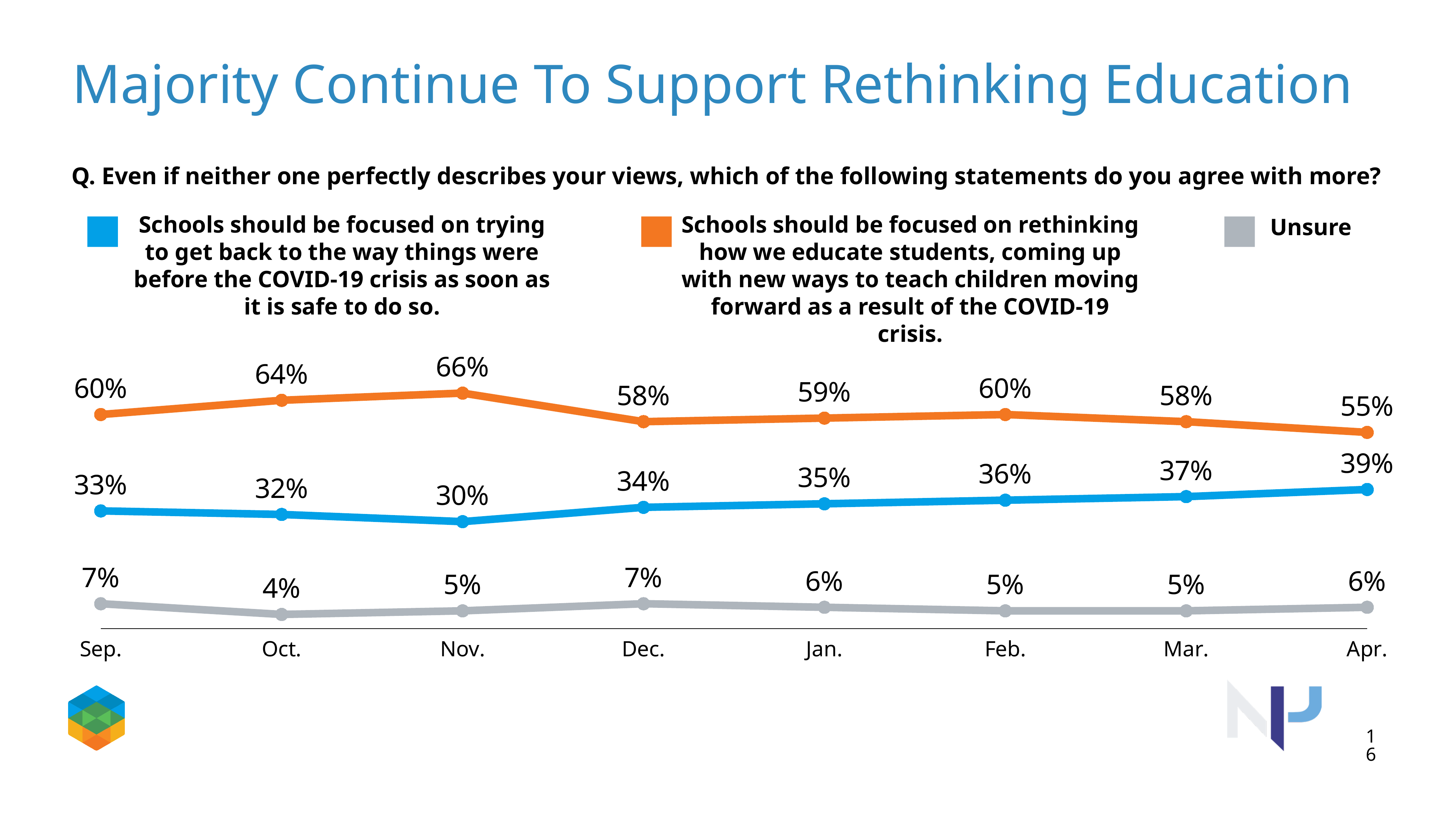
What percentage chose 'get back to the way things were' in Apr.? 39% Which is larger in Dec.: the 'rethinking' value or the 'get back' value? rethinking (58%) What percentage were Unsure in Oct.? 4% How many series does the legend list? 3 In which month was the 'get back to the way things were' series lowest? Nov. What is the difference between the 'rethinking' and 'get back' values in Apr.? 16% In which month was the 'rethinking how we educate students' series highest? Nov. What percentage chose 'rethinking how we educate students' in Nov.? 66% What colour represents the Unsure series? Gray From Nov. to Apr., does the 'get back to the way things were' series rise or fall? Rise How many months are shown on the x axis? 8 What kind of chart is shown on the slide? Line chart